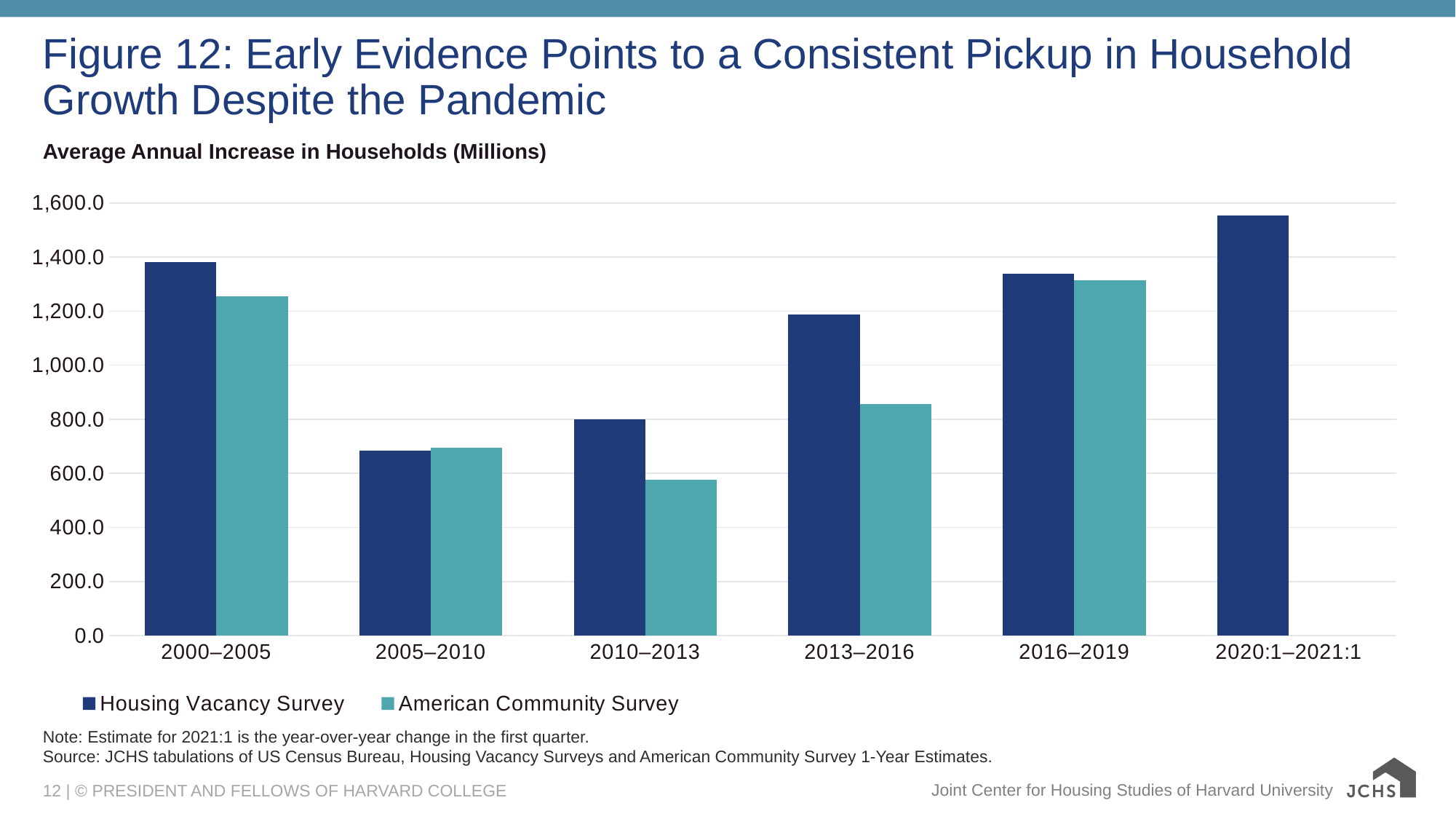
Is the American Community Survey value for 2010–2013 greater or less than 600.0? less Is the American Community Survey value for 2013–2016 greater or less than 800.0? greater How many time periods are shown on the x axis? 6 How many series does the legend list? 2 Which period has the highest Housing Vacancy Survey value? 2020:1–2021:1 Which period has the lowest Housing Vacancy Survey value? 2005–2010 Which period has the highest American Community Survey value? 2016–2019 For 2013–2016, which series has the larger value, Housing Vacancy Survey or American Community Survey? Housing Vacancy Survey What is the subtitle describing the measure plotted on the chart? Average Annual Increase in Households (Millions) Which period has the lowest American Community Survey value? 2010–2013 What kind of chart is shown on the slide? bar chart Is the Housing Vacancy Survey value for 2020:1–2021:1 greater or less than 1,400.0? greater